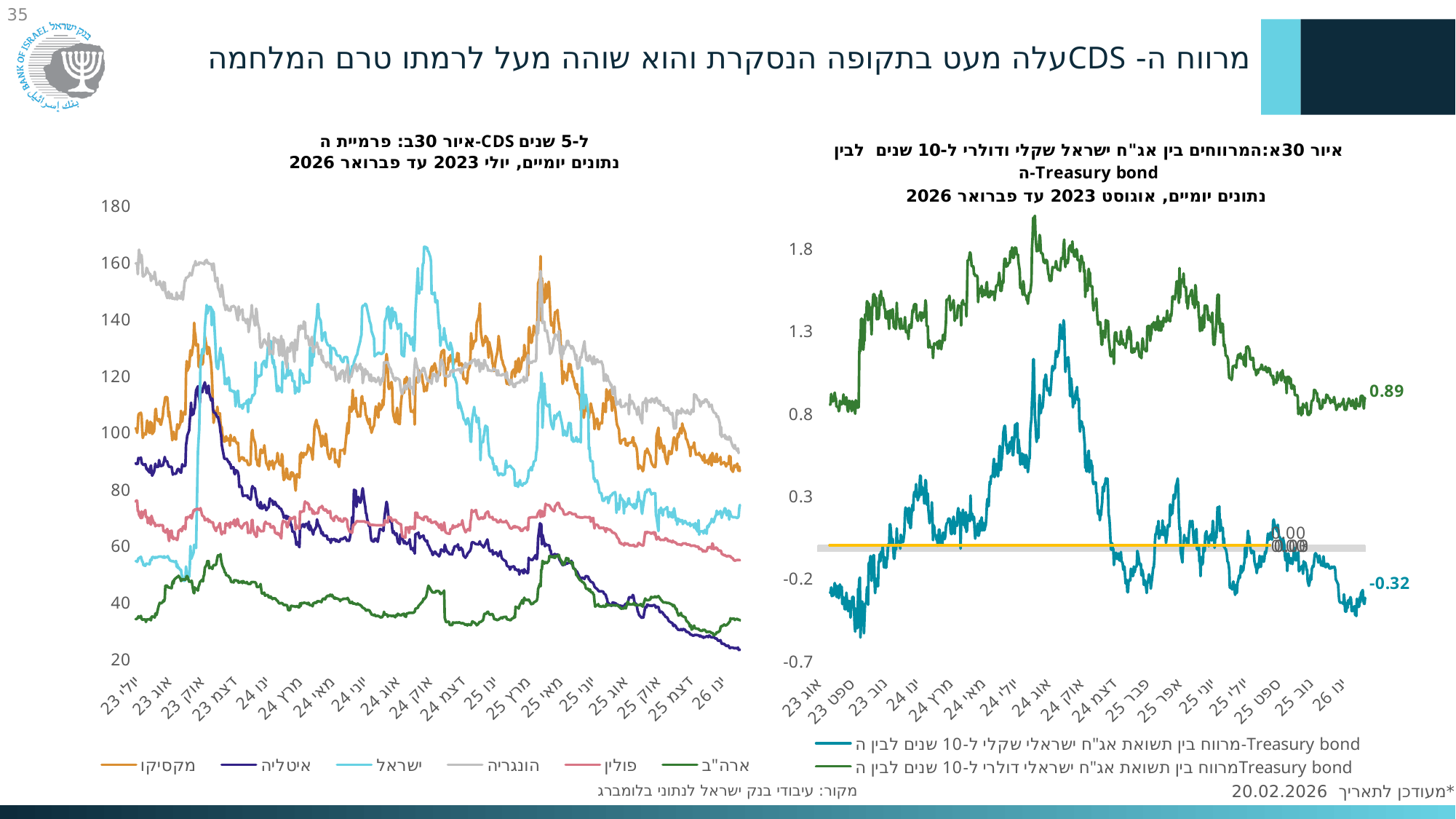
On the right chart (איור 30א), is the peak of the dollar-bond spread greater or less than 1.8? greater On the right chart (איור 30א), how many series does the legend list? 2 On the left chart (איור 30ב), which country has the lowest CDS premium at the end of the period (January 2026)? איטליה What kind of chart is the left chart (איור 30ב)? line chart On the left chart (איור 30ב), how many countries does the legend list? 6 On the left chart (איור 30ב), is the CDS premium for ישראל at the end of the period greater or less than 80? less On the left chart (איור 30ב), which country has the highest CDS premium at the start of the period (July 2023)? הונגריה On the right chart (איור 30א), which series ends higher in February 2026: the dollar-bond spread or the shekel-bond spread? the dollar-bond spread On the right chart (איור 30א), what is the final value shown for the spread between the Israeli dollar 10-year bond and the Treasury bond? 0.89 On the right chart (איור 30א), what is the difference between the final dollar-bond spread (0.89) and the final shekel-bond spread (-0.32)? 1.21 On the right chart (איור 30א), what is the final value shown for the spread between the Israeli shekel 10-year bond and the Treasury bond? -0.32 On the right chart (איור 30א), does the dollar-bond spread rise or fall from its peak in mid-2024 to February 2026? fall